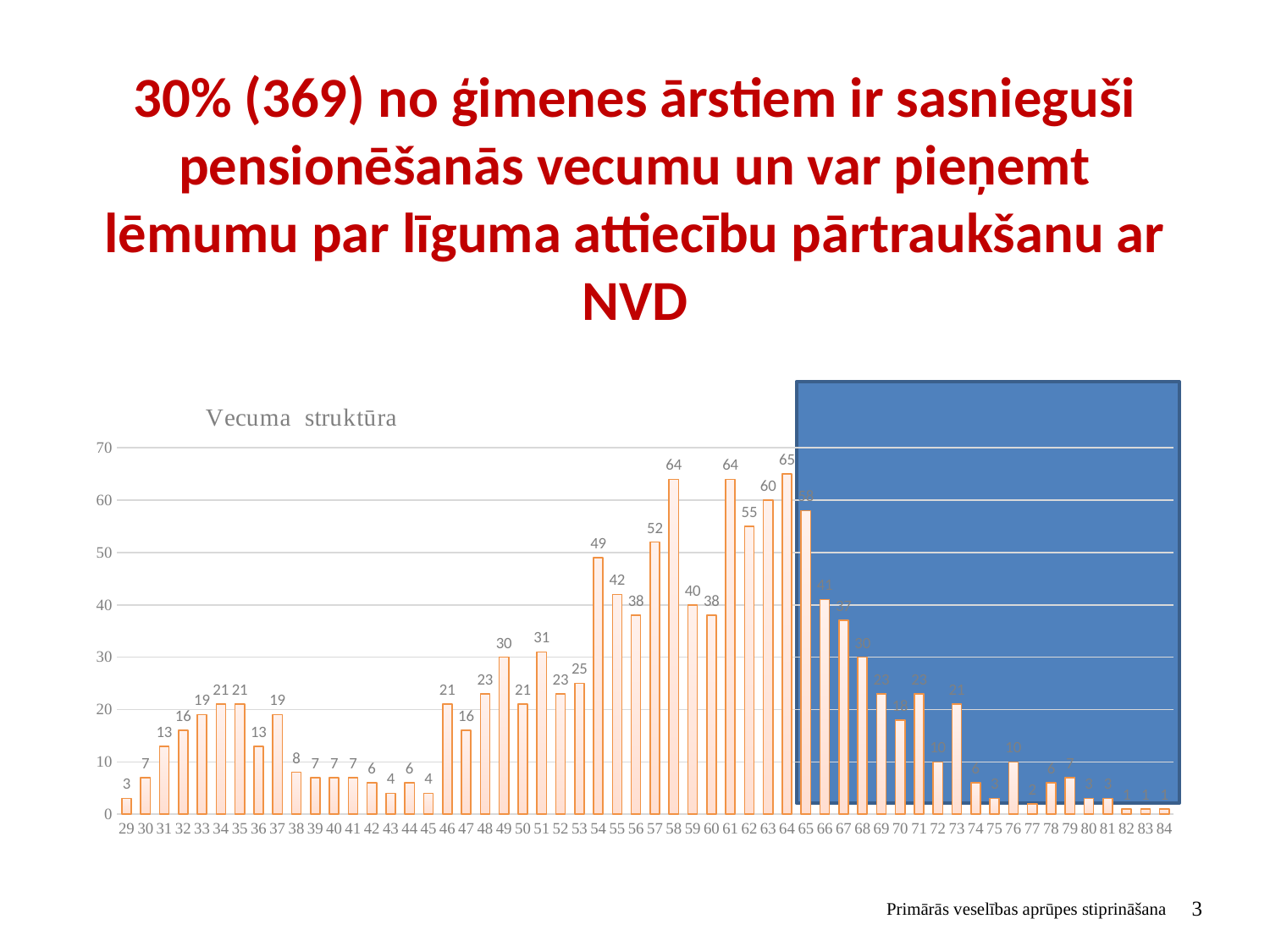
What is the value for age 33? 19 What is the value for age 58? 64 What is the difference between the values for age 58 and age 57? 12 How many age categories are shown on the x axis? 56 Which has a larger value, age 49 or age 51? 51 What is the value for age 29? 3 Is the value for age 65 greater or less than 50? greater Do the values rise or fall from age 29 to age 34? rise What is the title of the chart? Vecuma struktūra Which age has the highest value? 64 What is the value for age 54? 49 What kind of chart is shown on the slide? bar chart